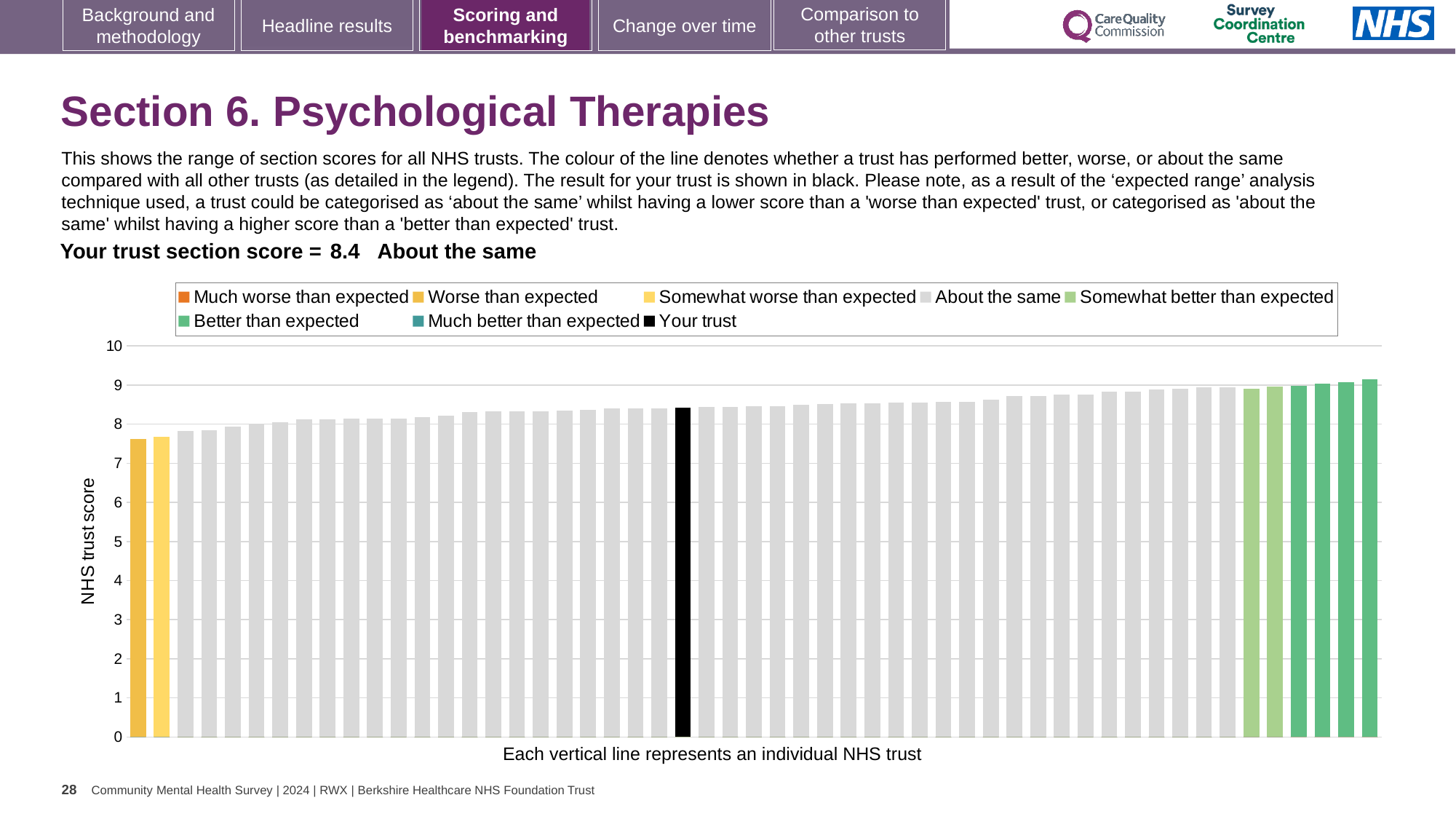
Which performance category is your trust placed in for Section 6? About the same Which legend category does the lowest bar belong to? Worse than expected What kind of chart is shown on the slide? bar chart Which legend category does the highest bar belong to? Better than expected What is the section score for your trust shown on the slide? 8.4 What is the label on the vertical axis of the chart? NHS trust score How many entries does the chart legend list? 8 Is the value of the rightmost bar greater or less than 9? greater Is the value of the black bar (your trust) greater or less than 8? greater Is the value of the leftmost bar greater or less than 8? less Do the bar values rise or fall from left to right along the x axis? rise Which is higher, the leftmost bar or the rightmost bar? the rightmost bar